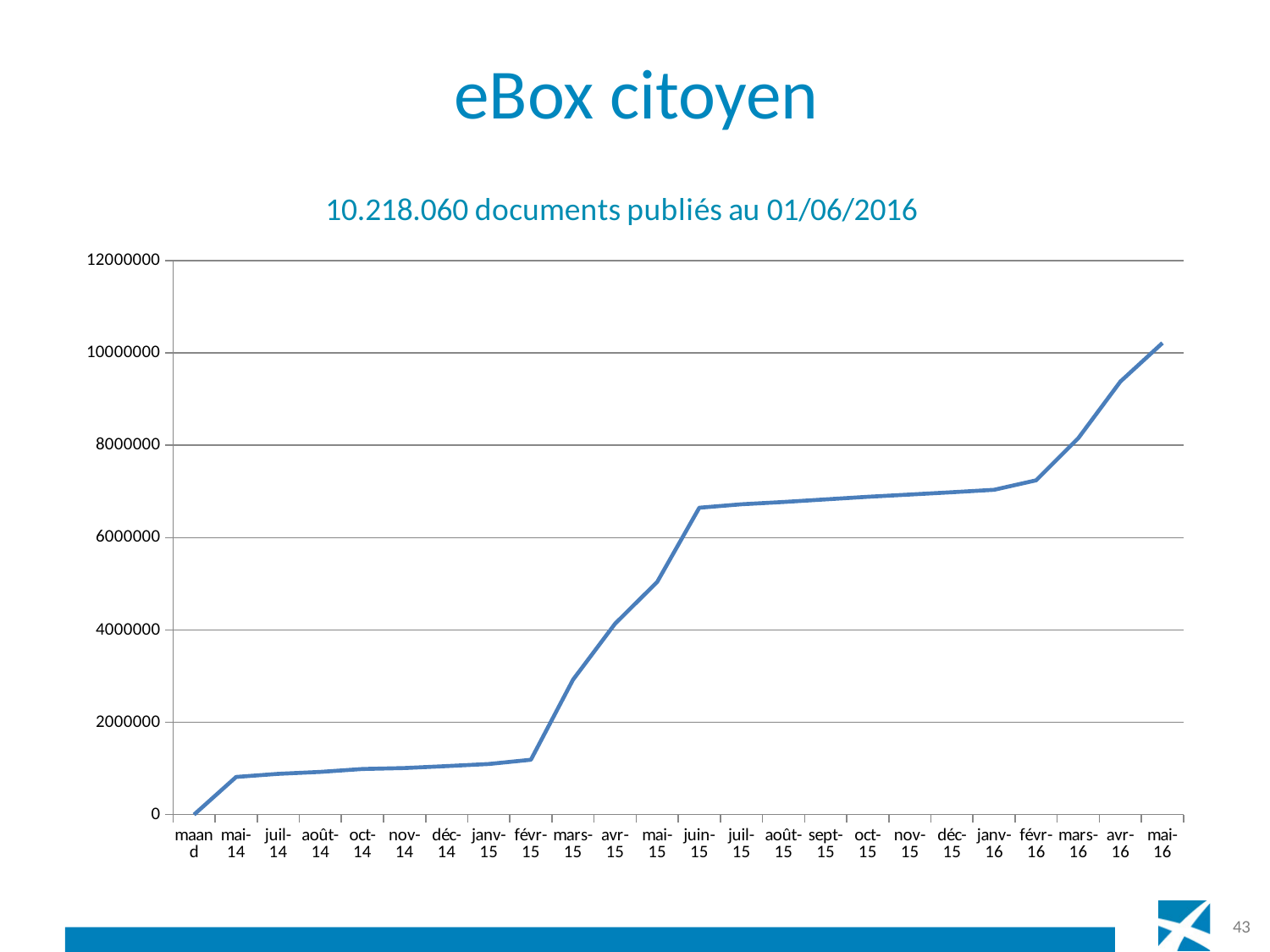
Which is larger, the value for juin-15 or the value for mars-15? juin-15 What kind of chart is shown on the slide? line chart Is the value for avr-16 greater or less than 8000000? greater Is the value for juin-15 greater or less than 6000000? greater Which category has the lowest value? maand Is the value for févr-15 greater or less than 2000000? less Do the values rise or fall along the x axis from maand to mai-16? rise Which category has the highest value? mai-16 What is the title of the slide containing the chart? eBox citoyen How many points are plotted along the x axis? 24